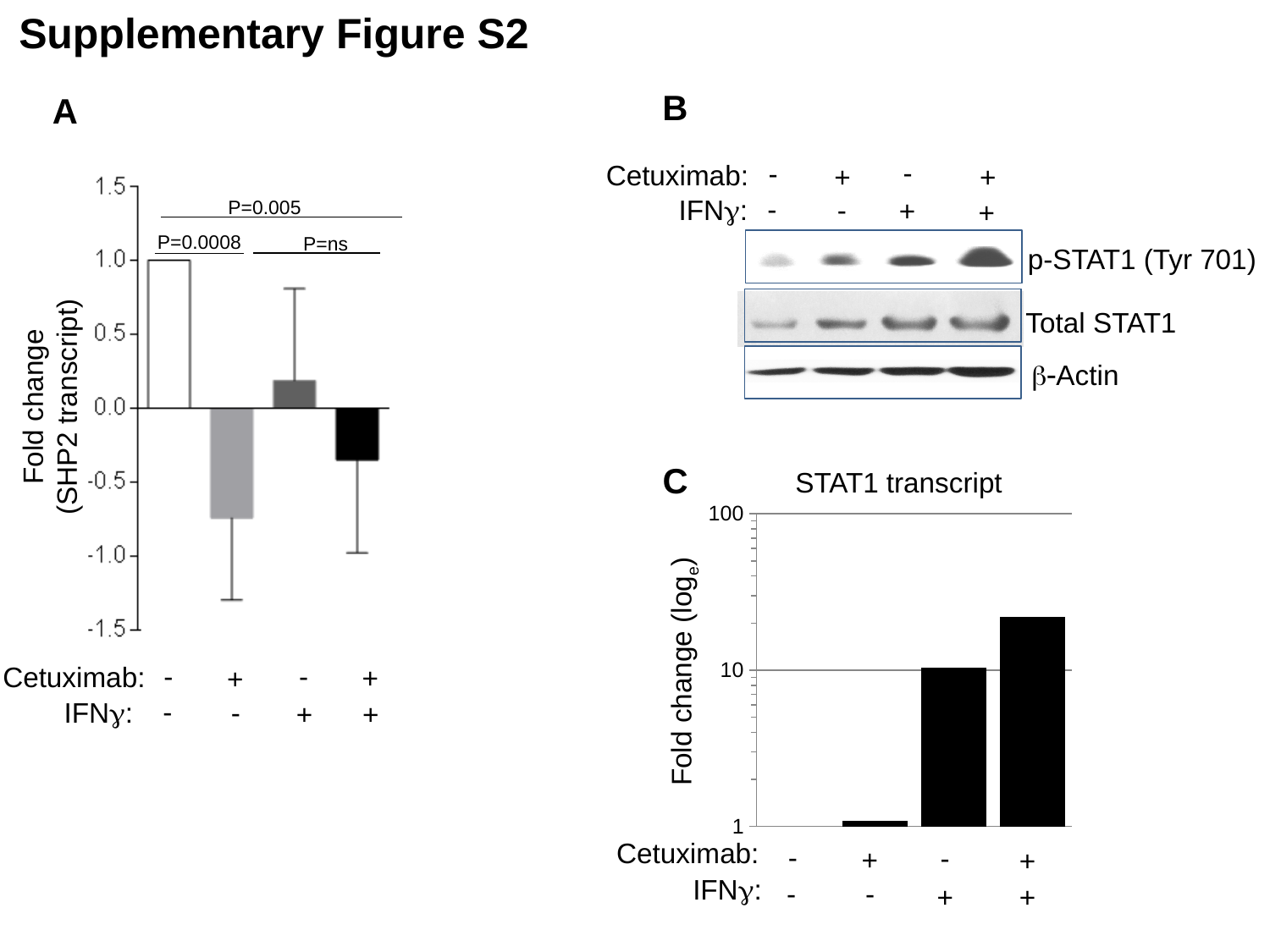
In panel A (Fold change SHP2 transcript), what kind of chart is shown? bar chart In panel A (Fold change SHP2 transcript), is the fold change for the Cetuximab +, IFNγ + condition greater or less than -0.5? greater In panel A (Fold change SHP2 transcript), how many bars (treatment conditions) are plotted? 4 In panel C (STAT1 transcript), what kind of chart is shown? bar chart In panel A (Fold change SHP2 transcript), is the fold change for the Cetuximab +, IFNγ - condition greater or less than -0.5? less In panel C (STAT1 transcript), which has the larger fold change: Cetuximab +, IFNγ - or Cetuximab -, IFNγ +? Cetuximab -, IFNγ + In panel A (Fold change SHP2 transcript), which treatment condition has the lowest fold change? Cetuximab +, IFNγ - In panel C (STAT1 transcript), which treatment condition has the highest fold change? Cetuximab +, IFNγ + In panel A (Fold change SHP2 transcript), what P value is shown between the Cetuximab -, IFNγ - and Cetuximab +, IFNγ - bars? P=0.0008 In panel C (STAT1 transcript), is the fold change for the Cetuximab +, IFNγ + condition greater or less than 10? greater In panel A (Fold change SHP2 transcript), which treatment condition has the highest fold change? Cetuximab -, IFNγ - In panel A (Fold change SHP2 transcript), what is the fold change for the Cetuximab -, IFNγ - condition? 1.0